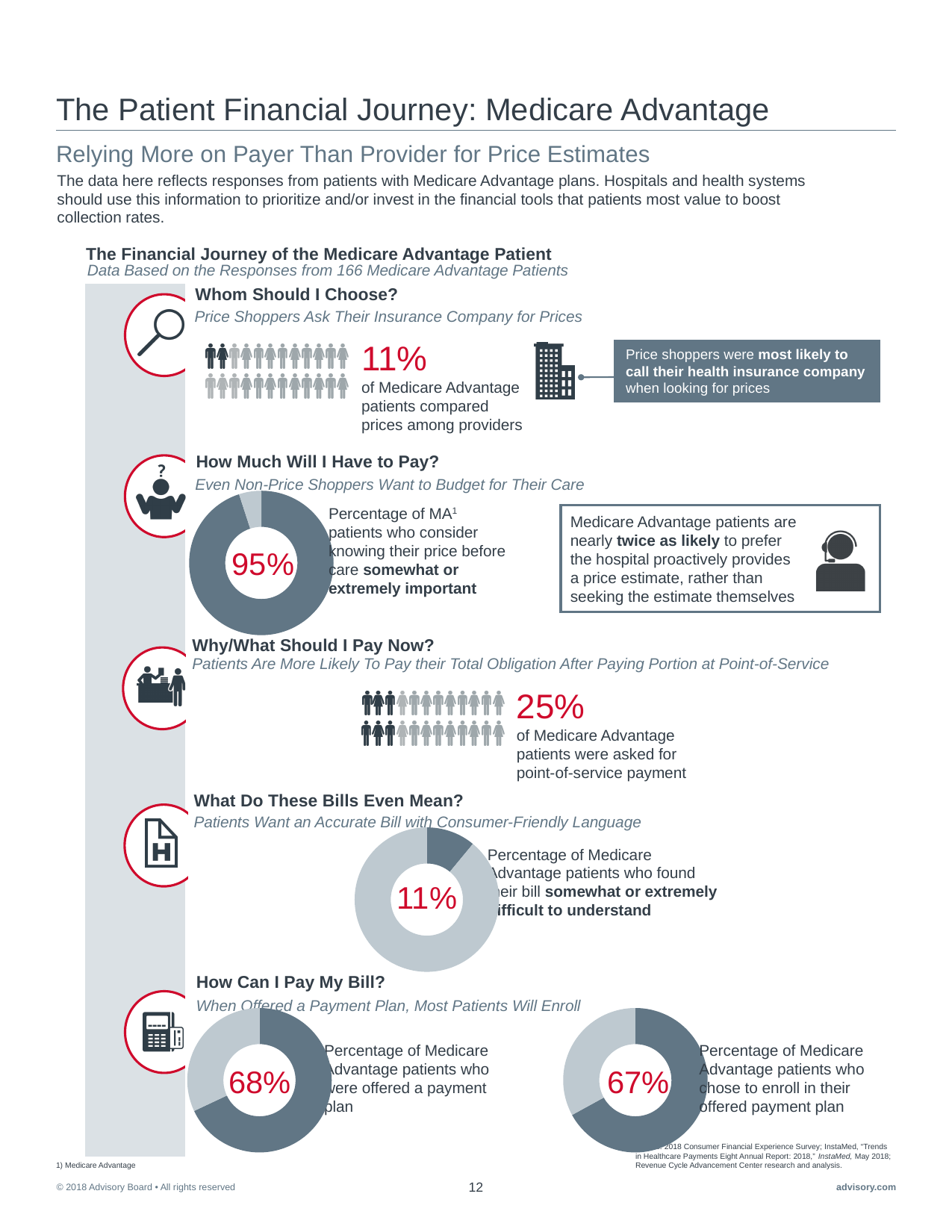
In the 'How Can I Pay My Bill?' section, what is the difference in percentage points between the patients offered a payment plan (68%) and those who enrolled in their offered plan (67%)? 1 percentage point In the 'How Much Will I Have to Pay?' section, what percentage of Medicare Advantage patients consider knowing their price before care somewhat or extremely important, according to the donut chart? 95% In the 'Whom Should I Choose?' section, what percentage of Medicare Advantage patients compared prices among providers, according to the people-icon graphic? 11% In the 'How Can I Pay My Bill?' section, what percentage of Medicare Advantage patients were offered a payment plan, according to the left donut chart? 68% In the 'Why/What Should I Pay Now?' section, what percentage of Medicare Advantage patients were asked for point-of-service payment, according to the people-icon graphic? 25% Of the four donut charts on the slide, which shows the highest percentage? The 'How Much Will I Have to Pay?' chart (95%) In the 'What Do These Bills Even Mean?' section, what percentage of Medicare Advantage patients found their bill somewhat or extremely difficult to understand, according to the donut chart? 11% In the 'How Can I Pay My Bill?' section, what percentage of Medicare Advantage patients chose to enroll in their offered payment plan, according to the right donut chart? 67% In the 'How Can I Pay My Bill?' section, which is larger: the percentage of patients offered a payment plan or the percentage who chose to enroll in their offered payment plan? Offered a payment plan (68%) How many donut charts are shown on the slide? 4 Of the four donut charts on the slide, which shows the lowest percentage? The 'What Do These Bills Even Mean?' chart (11%) What kind of chart is used to show the 95% figure in the 'How Much Will I Have to Pay?' section? Donut chart